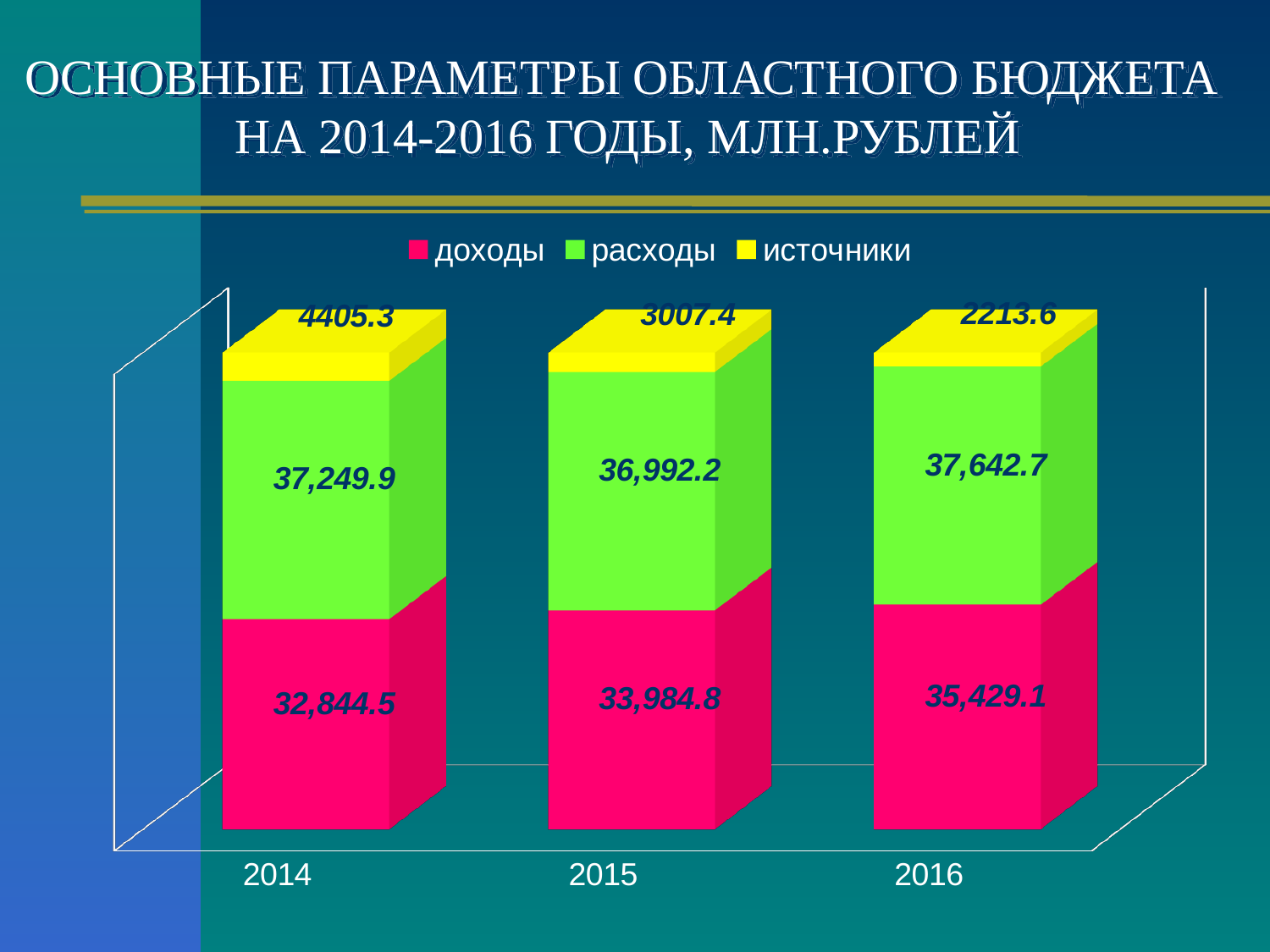
In which year is источники the lowest? 2016 How many series does the legend list? 3 What type of chart is shown on the slide? stacked bar chart In which year is доходы the highest? 2016 How many years (categories) are shown on the x axis? 3 What is the value of доходы for 2014? 32,844.5 What is the value of источники for 2016? 2213.6 What is the value of расходы for 2015? 36,992.2 Which colour represents the series доходы in the legend? pink Which is larger: расходы in 2014 or расходы in 2015? расходы in 2014 What is the difference between доходы in 2016 and доходы in 2014? 2,584.6 Do the values of источники rise or fall from 2014 to 2016? fall